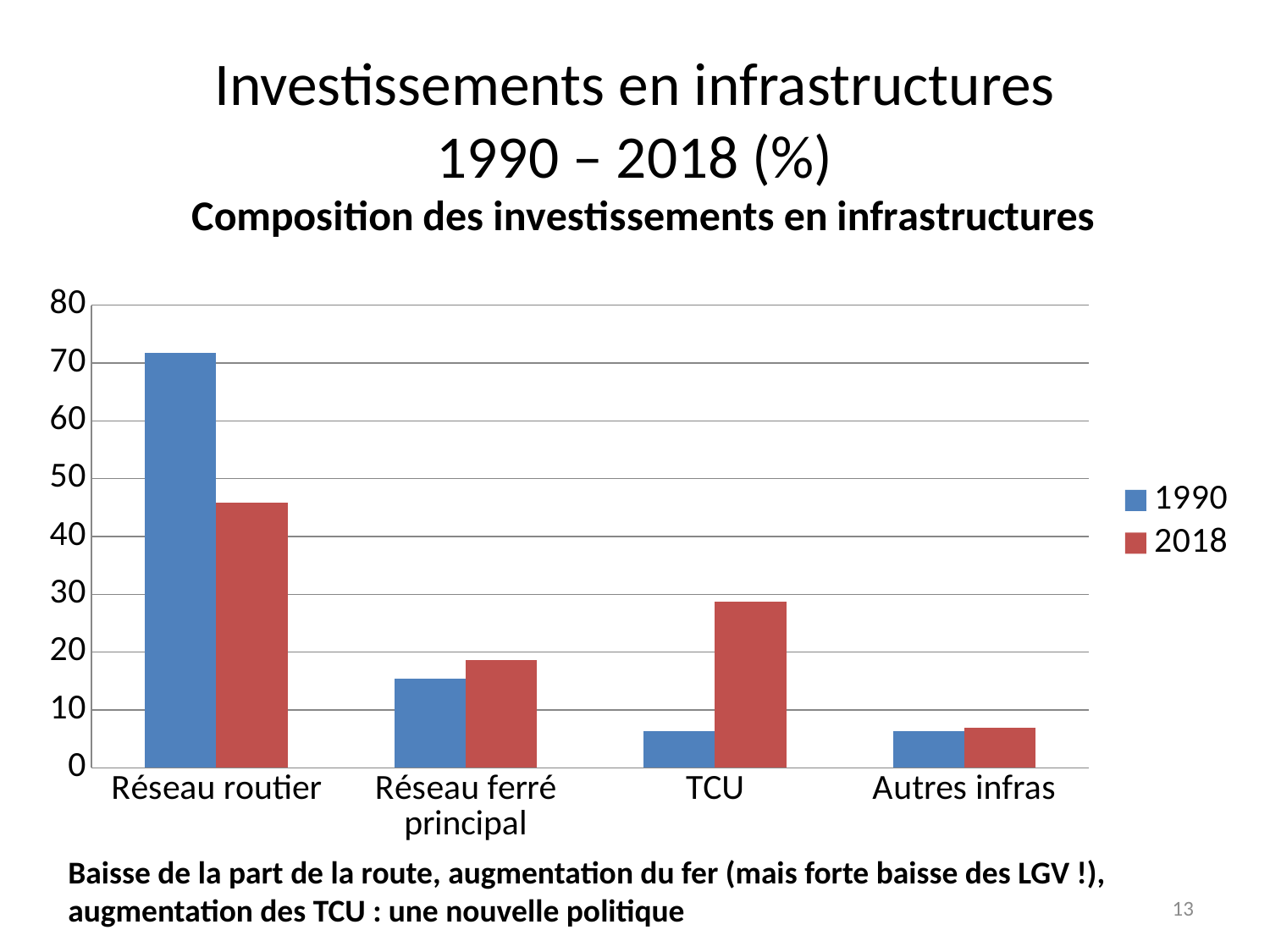
For Réseau routier, which is larger: the 1990 value or the 2018 value? 1990 How many series does the legend list? 2 What is the title of the chart? Composition des investissements en infrastructures What kind of chart is shown on the slide? bar chart For TCU, which is larger: the 1990 value or the 2018 value? 2018 Is the 1990 value for Réseau routier greater or less than 60? greater Is the 2018 value for TCU greater or less than 20? greater Which category has the highest value for 2018? Réseau routier Which category has the lowest value for 2018? Autres infras Which category has the highest value for 1990? Réseau routier How many categories are shown on the x axis? 4 Is the 2018 value for Réseau routier greater or less than 50? less